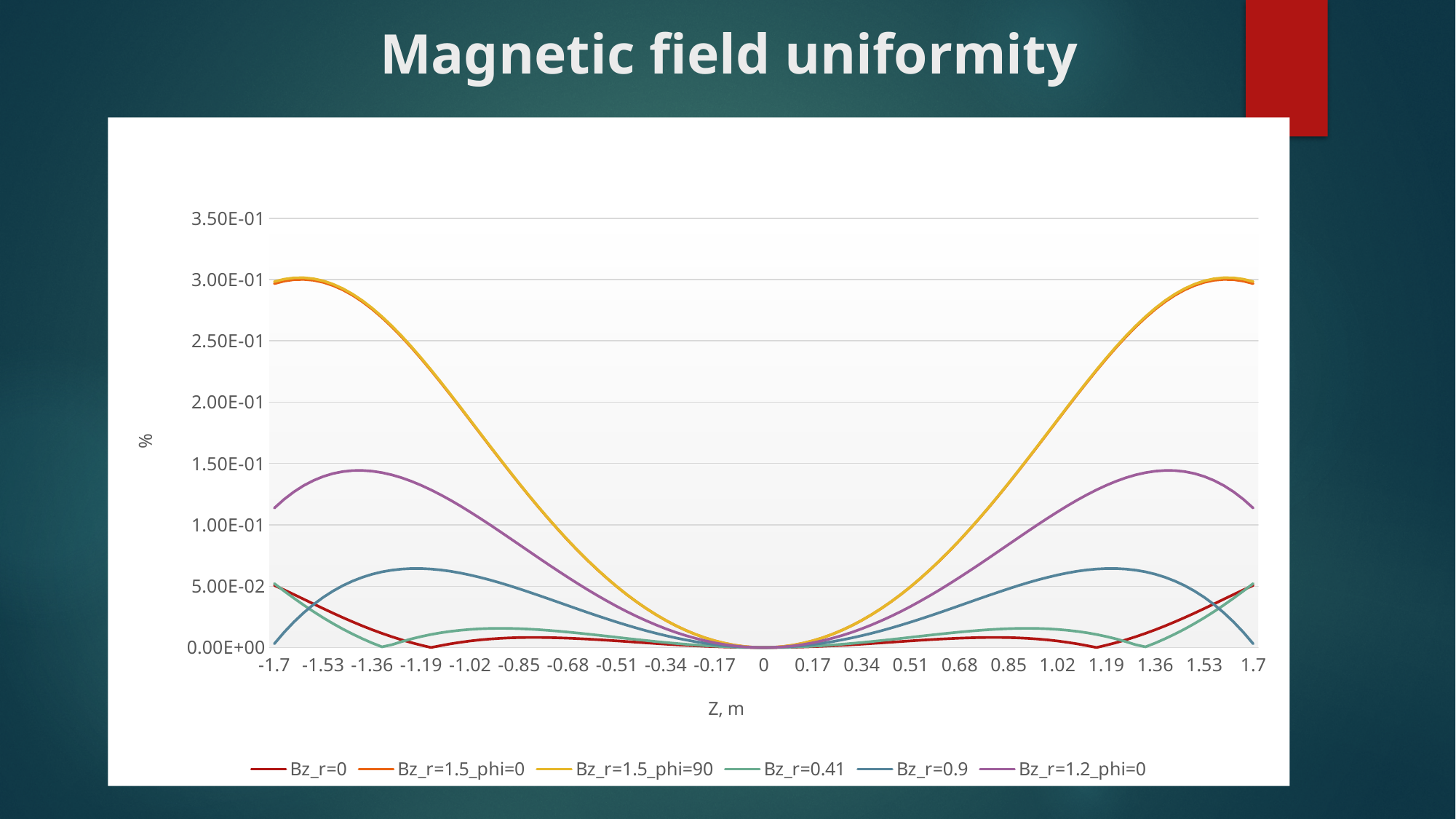
What is the title of the chart? Magnetic field uniformity Is the value of the Bz_r=1.5_phi=0 series at Z = 0 greater or less than 5.00E-02? less Is the peak value of the Bz_r=1.2_phi=0 series greater or less than 1.00E-01? greater Does the Bz_r=1.5_phi=90 series rise or fall as Z goes from 0 to 1.53? Rise How many tick labels are shown on the x axis? 21 Is the peak value of the Bz_r=0.9 series greater or less than 5.00E-02? greater At Z = 1.02, which series has the larger value, Bz_r=1.5_phi=90 or Bz_r=0.41? Bz_r=1.5_phi=90 At Z = -0.85, which series has the larger value, Bz_r=1.2_phi=0 or Bz_r=0.9? Bz_r=1.2_phi=0 How many series does the legend list? 6 What type of chart is shown on the slide? Line chart What is the label of the x axis? Z, m